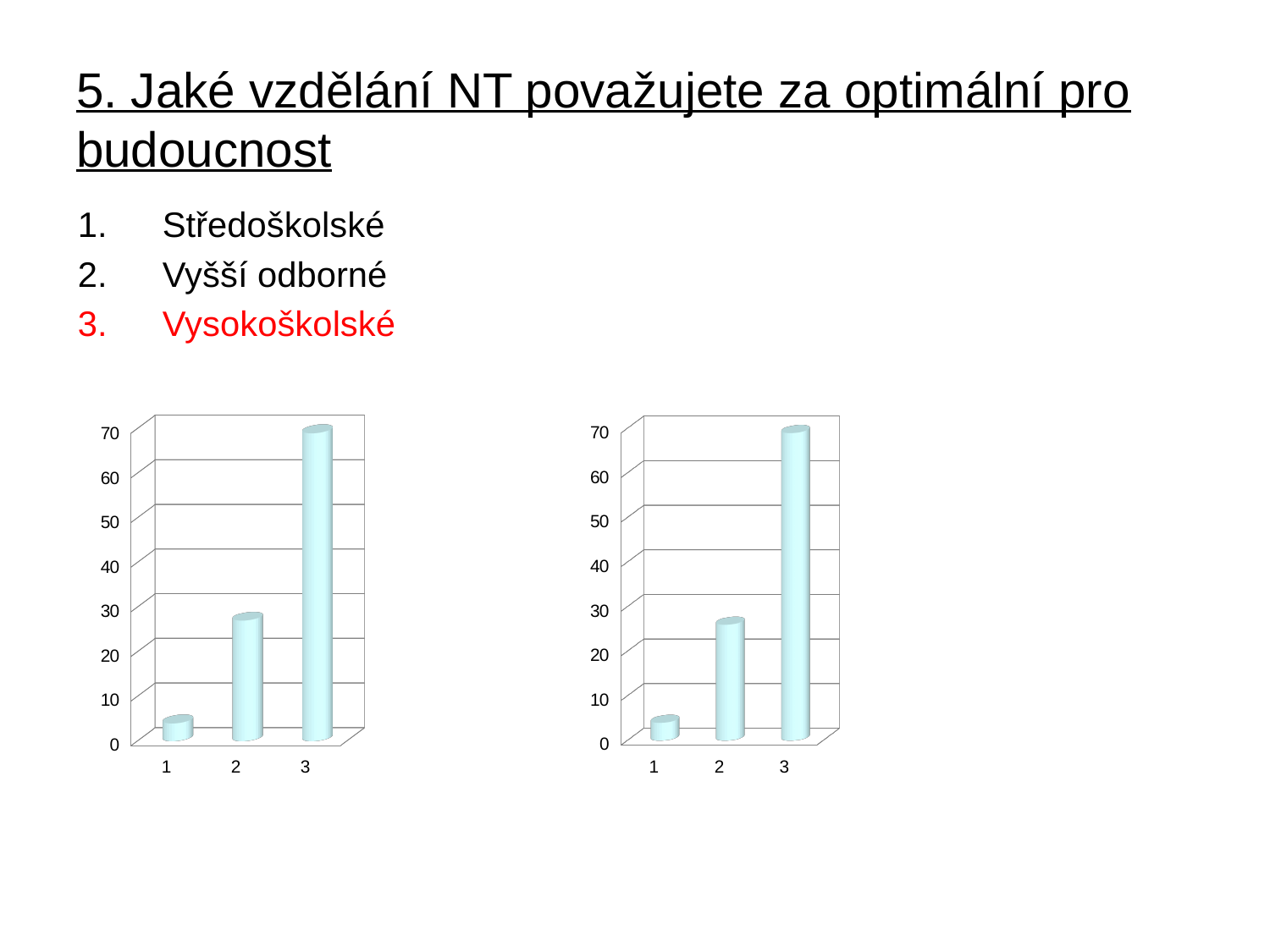
On the left chart, which is larger, the value for category 2 or category 3? 3 On the right chart, is the value for category 2 greater or less than 20? greater On the right chart, which category has the lowest bar? 1 On the left chart, is the value for category 2 greater or less than 30? less What kind of chart is the left chart? bar chart How many categories are shown on the right chart? 3 What is the highest value shown on the vertical axis of the right chart? 70 On the right chart, which category has the highest bar? 3 On the left chart, is the value for category 3 greater or less than 60? greater On the left chart, which category has the highest bar? 3 On the left chart, which category has the lowest bar? 1